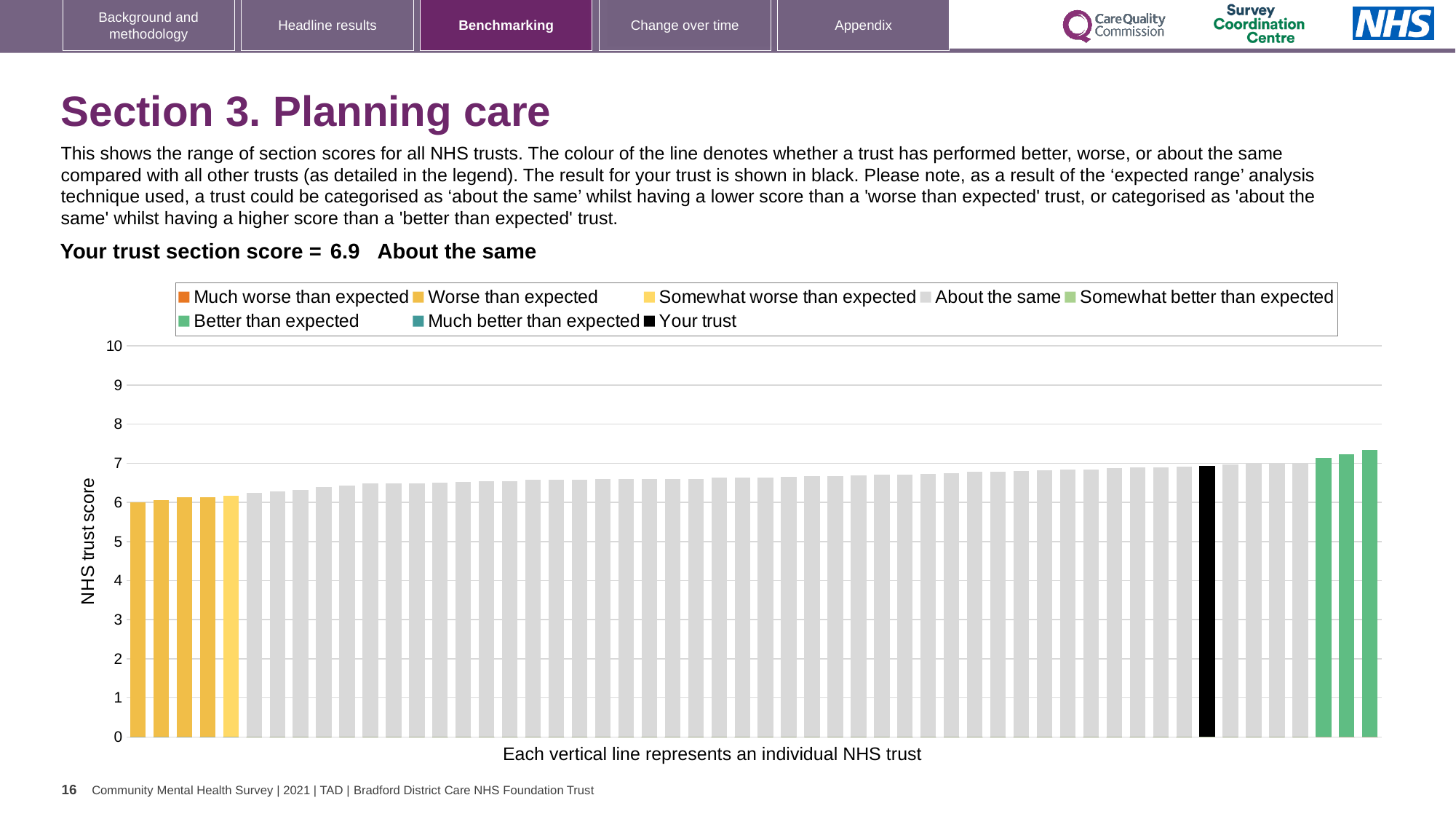
Do the bar values rise or fall from left to right along the x axis? Rise How many bars are coloured green (better than expected)? 3 Is the shortest bar in the chart greater or less than 5? greater What kind of chart is shown on the slide? Bar chart Is the tallest bar in the chart greater or less than 8? less Which benchmarking category is your trust placed in for this section? About the same Is the value for your trust (the black bar) greater or less than 5? greater What is your trust's section score for Planning care? 6.9 What is the label on the vertical axis of the chart? NHS trust score Is your trust's bar taller or shorter than the tallest green bar? Shorter According to the caption under the chart, what does each vertical line represent? An individual NHS trust How many entries does the chart legend list? 8